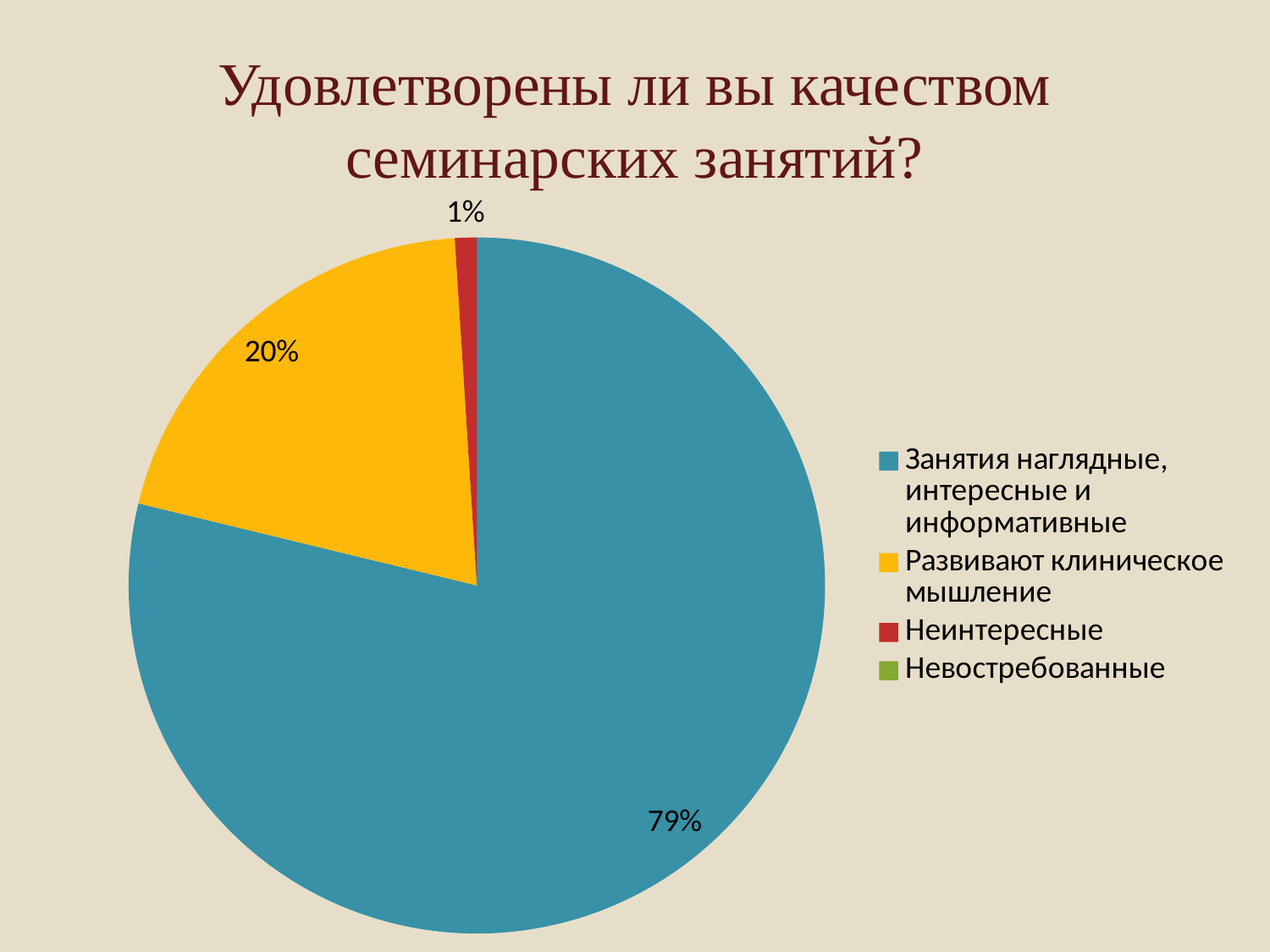
What colour is the slice for "Развивают клиническое мышление"? yellow What kind of chart is shown on the slide? pie chart What is the title of the chart? Удовлетворены ли вы качеством семинарских занятий? What share of the pie is labelled for "Занятия наглядные, интересные и информативные"? 79% What is the difference in percentage points between the "Занятия наглядные, интересные и информативные" slice and the "Развивают клиническое мышление" slice? 59 Which category has the largest slice of the pie? Занятия наглядные, интересные и информативные What share of the pie is labelled for "Неинтересные"? 1% How many entries does the legend list? 4 What is the combined share of the "Развивают клиническое мышление" and "Неинтересные" slices? 21% What share of the pie is labelled for "Развивают клиническое мышление"? 20% Which of the labelled slices is the smallest? Неинтересные Which is larger: the "Развивают клиническое мышление" slice or the "Неинтересные" slice? Развивают клиническое мышление